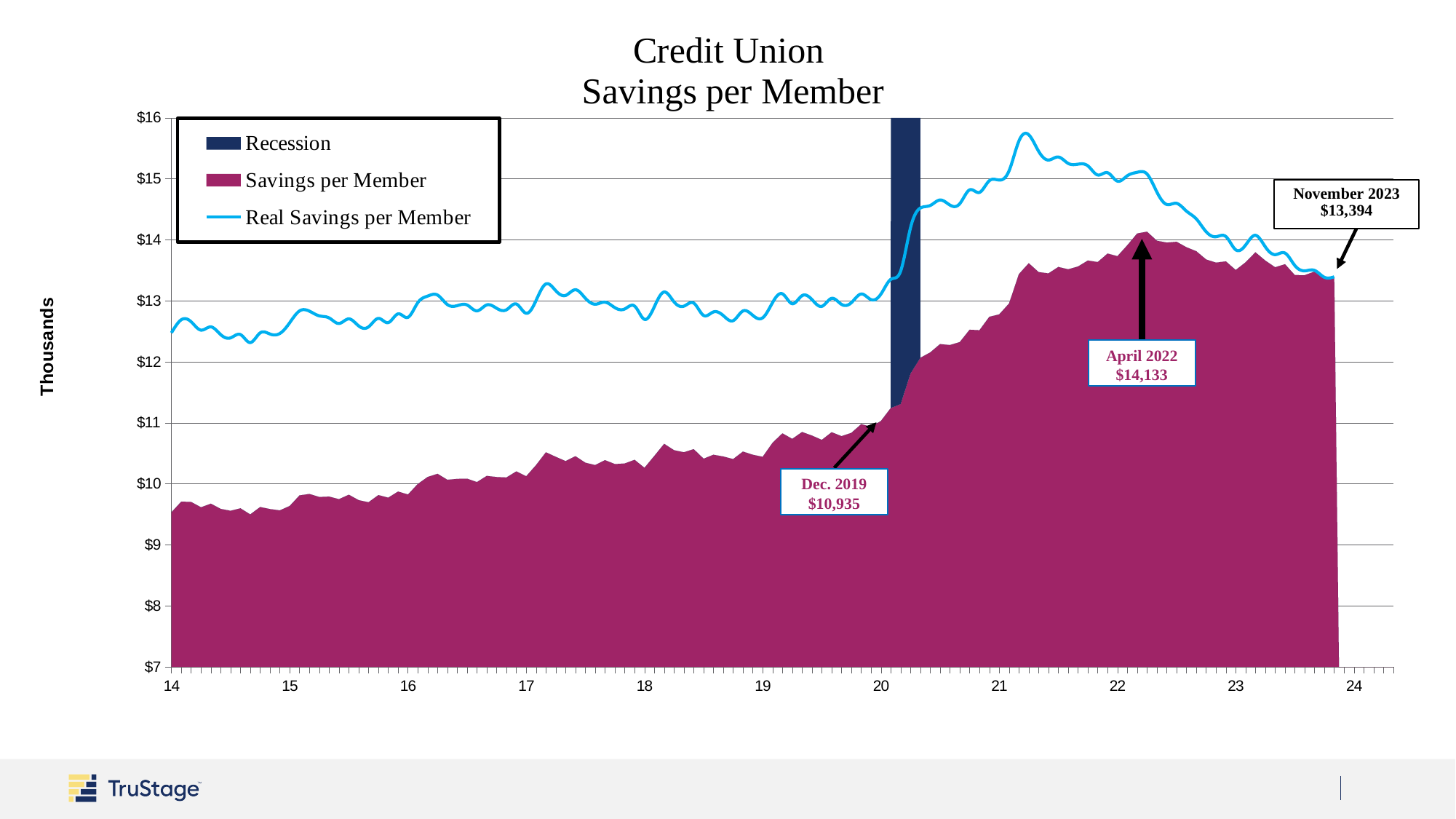
How much higher was Savings per Member in April 2022 than in Dec. 2019? $3,198 At the start of 2014, is Savings per Member greater or less than $10 thousand? less How many series does the legend list? 3 By how much did Savings per Member fall from April 2022 to November 2023? $739 What value is labelled for April 2022? $14,133 What was Savings per Member in November 2023? $13,394 Does Real Savings per Member rise or fall between 2022 and 2023? falls Which is larger, the labelled value for April 2022 or for November 2023? April 2022 What was Savings per Member in Dec. 2019 according to the annotation? $10,935 Does Savings per Member rise or fall between 2014 and 2020? rises What unit is shown on the vertical axis label? Thousands At the start of 2014, is Real Savings per Member greater or less than $12 thousand? greater